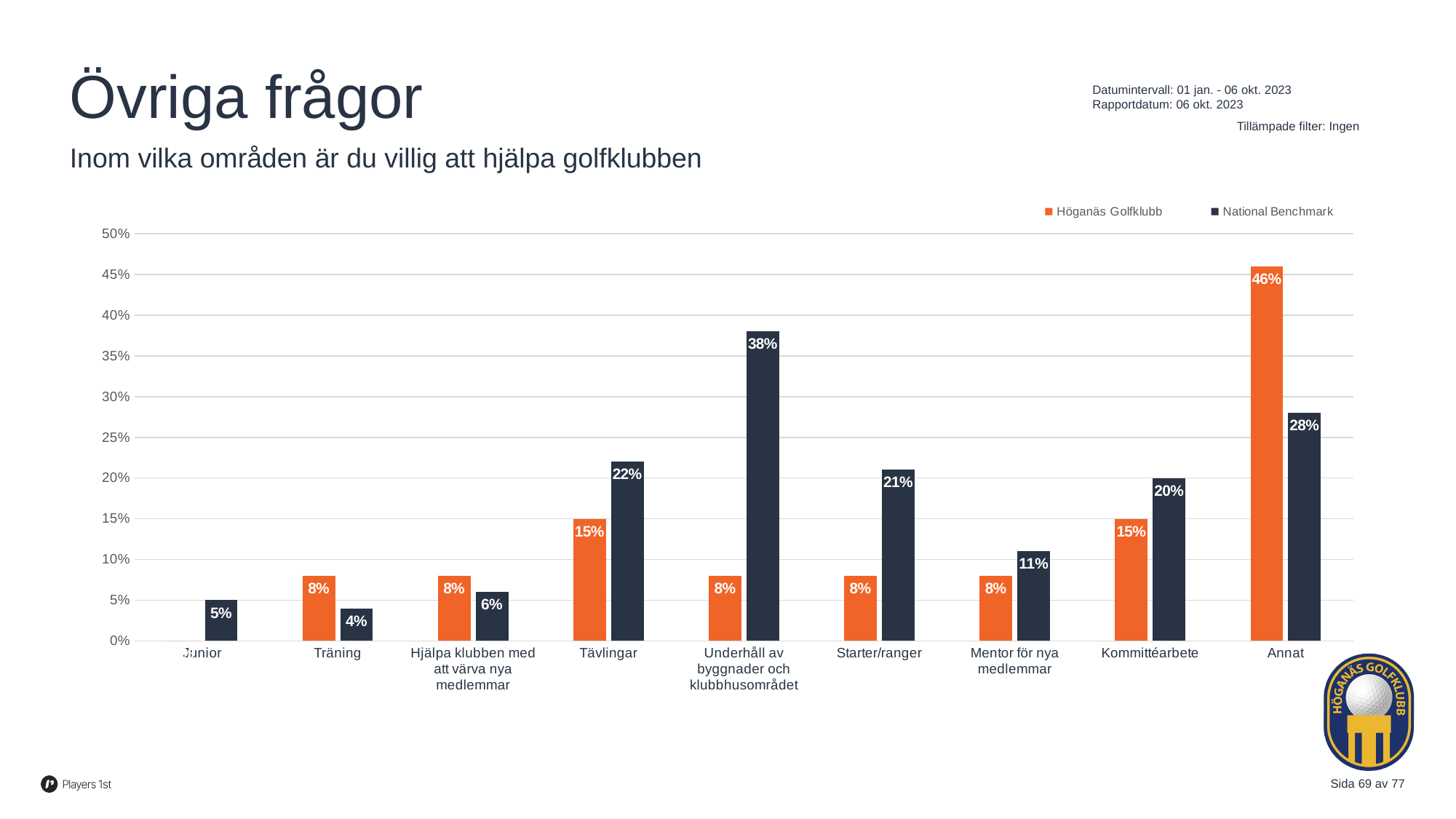
Which category has the lowest National Benchmark value? Träning How many categories are shown on the x axis? 9 What is the difference between the National Benchmark and Höganäs Golfklubb values for Underhåll av byggnader och klubbhusområdet? 30% How many series does the legend list? 2 For Annat, which is larger: the Höganäs Golfklubb value or the National Benchmark value? Höganäs Golfklubb What is the Höganäs Golfklubb value for Annat? 46% Is the National Benchmark value for Starter/ranger greater or less than 15%? greater What kind of chart is shown on the slide? Bar chart What is the National Benchmark value for Underhåll av byggnader och klubbhusområdet? 38% Which category has the highest Höganäs Golfklubb value? Annat What is the National Benchmark value for Mentor för nya medlemmar? 11% What is the Höganäs Golfklubb value for Tävlingar? 15%